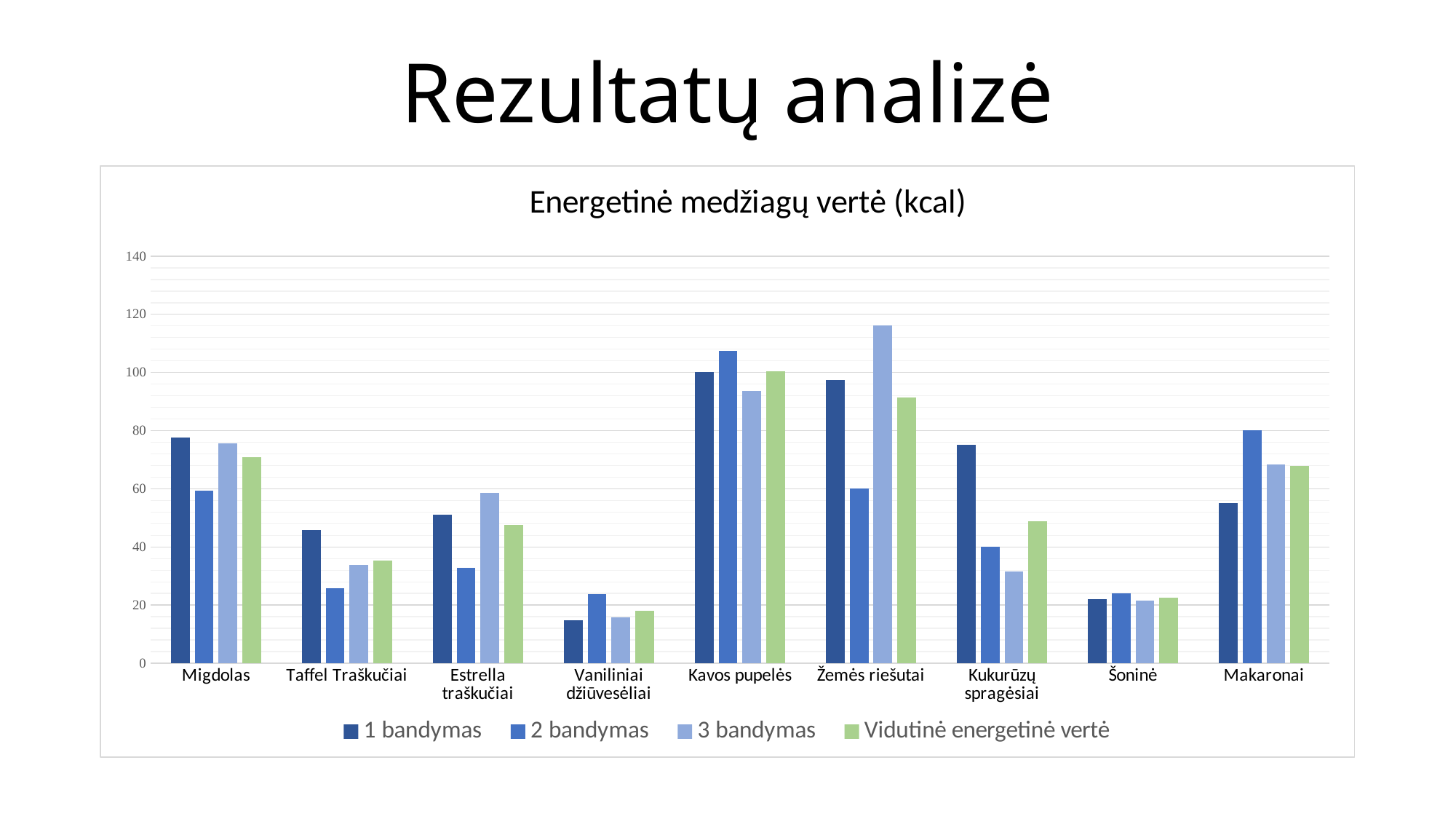
Is the Vidutinė energetinė vertė value for Šoninė greater or less than 40? less What kind of chart is shown on the slide? bar chart What is the title of the chart? Energetinė medžiagų vertė (kcal) Which series is shown in green in the legend? Vidutinė energetinė vertė Is the 2 bandymas value for Taffel Traškučiai greater or less than 40? less Which category has the highest value for the 2 bandymas series? Kavos pupelės Which has the larger 1 bandymas value: Kukurūzų spragėsiai or Makaronai? Kukurūzų spragėsiai Is the 1 bandymas value for Migdolas greater or less than 60? greater How many product categories are shown on the x axis? 9 Which category has the lowest value for the Vidutinė energetinė vertė series? Vaniliniai džiūvesėliai How many series does the legend list? 4 Which category has the highest value for the 3 bandymas series? Žemės riešutai